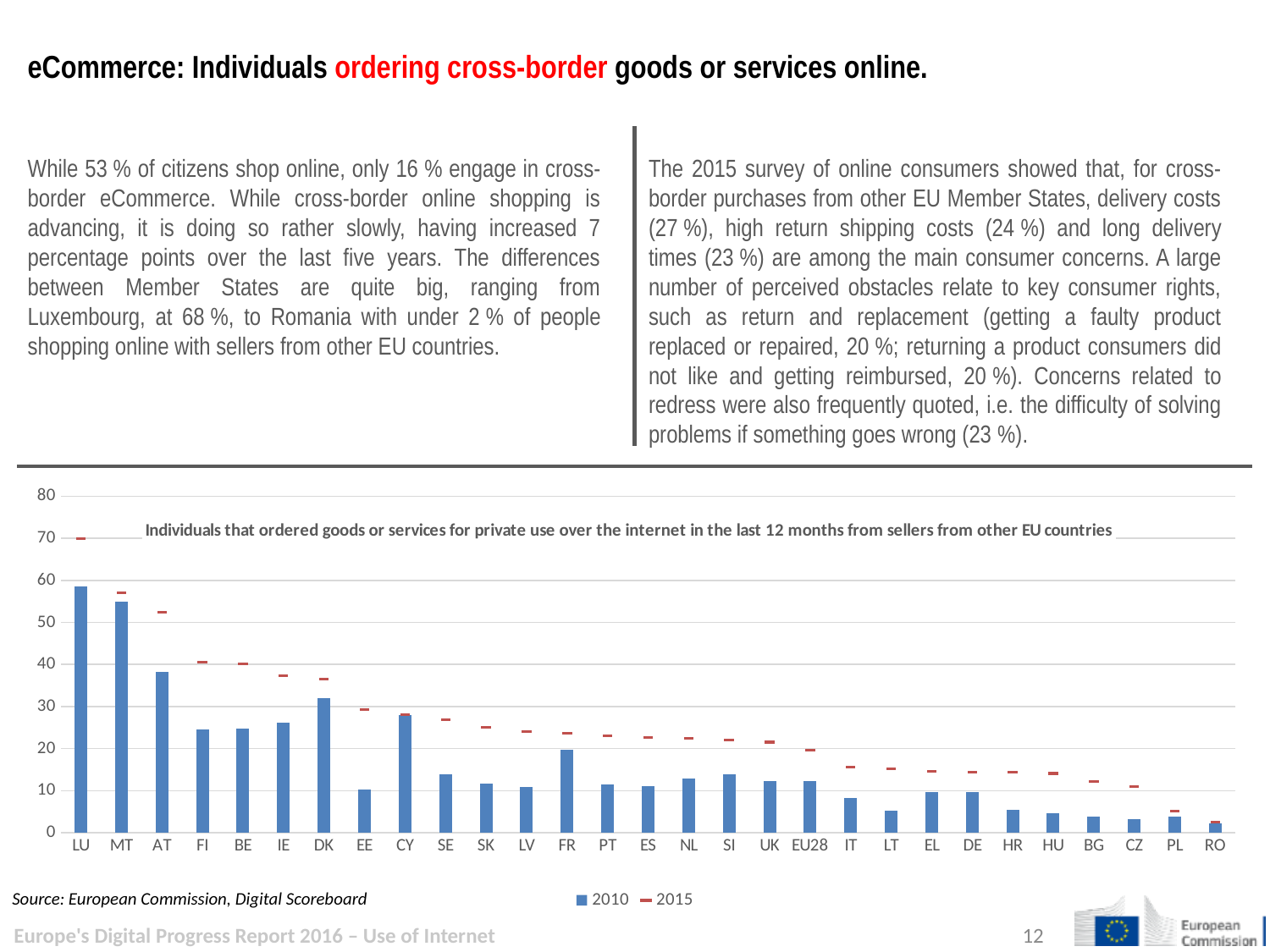
Which country has the lowest 2010 value in the chart? RO Which country has the highest 2010 value in the chart? LU How many series does the chart legend list? 2 Which has the larger 2010 value, AT or FI? AT What kind of chart is shown on the slide? bar chart Is the 2010 value for AT greater or less than 40? less How many countries/categories are shown on the x axis of the chart? 29 Is the 2010 value for IT greater or less than 10? less Is the 2010 value for LU greater or less than 50? greater Which series is shown as blue bars in the chart? 2010 Do the 2010 values generally rise or fall moving from left to right along the x axis? fall